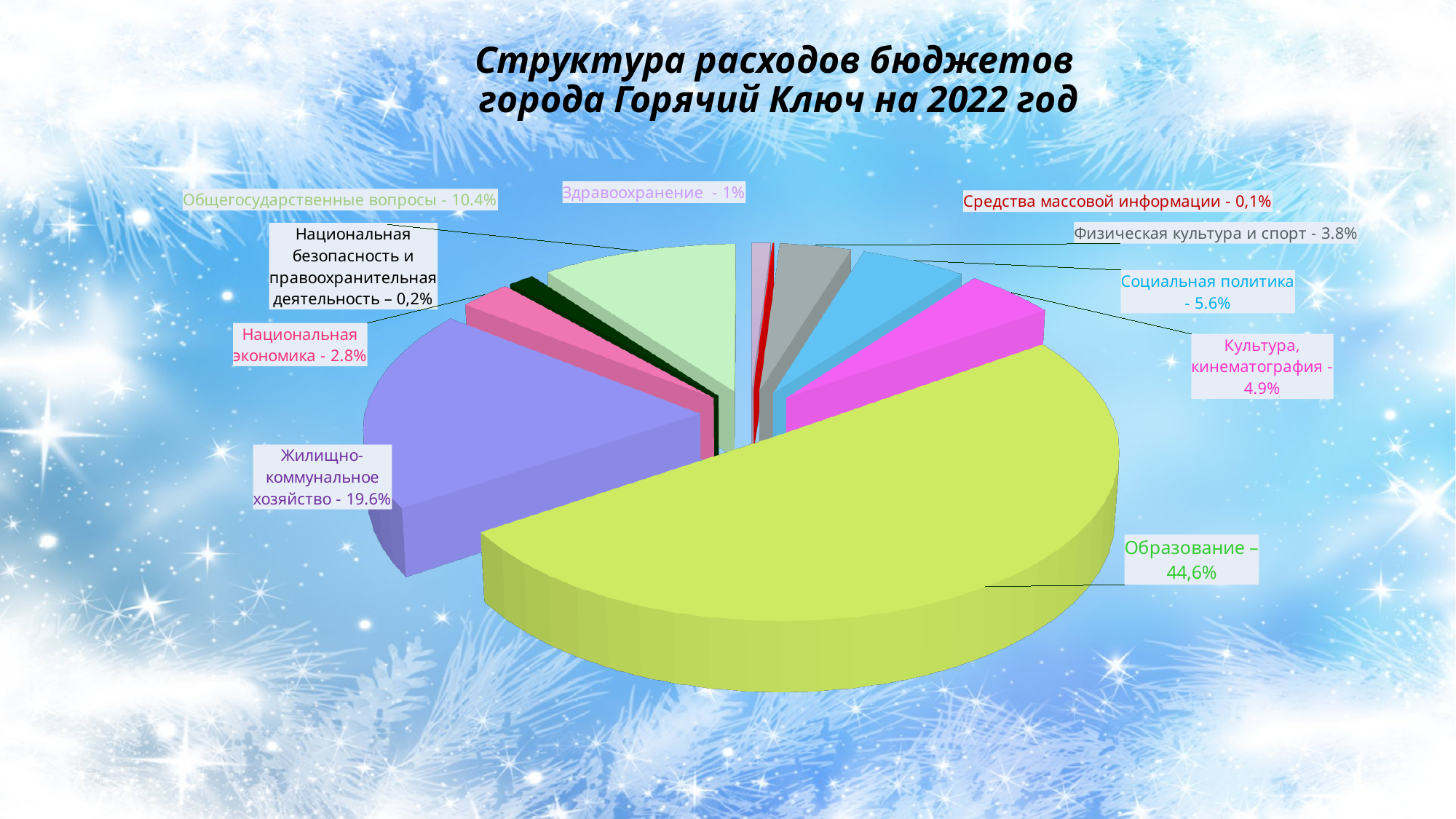
What is the title of the chart? Структура расходов бюджетов города Горячий Ключ на 2022 год What is the difference between the shares of Жилищно-коммунальное хозяйство and Общегосударственные вопросы? 9.2% What is the value shown for Средства массовой информации? 0,1% Which category has the largest share of the budget expenditure? Образование What is the value shown for Жилищно-коммунальное хозяйство? 19.6% Which is larger: Социальная политика or Культура, кинематография? Социальная политика What is the value shown for Общегосударственные вопросы? 10.4% What is the value shown for Национальная безопасность и правоохранительная деятельность? 0,2% Which category has the smallest share of the budget expenditure? Средства массовой информации What kind of chart is shown on the slide? Pie chart What share of the budget expenditure goes to Образование? 44,6% How many categories are shown in the pie chart? 10